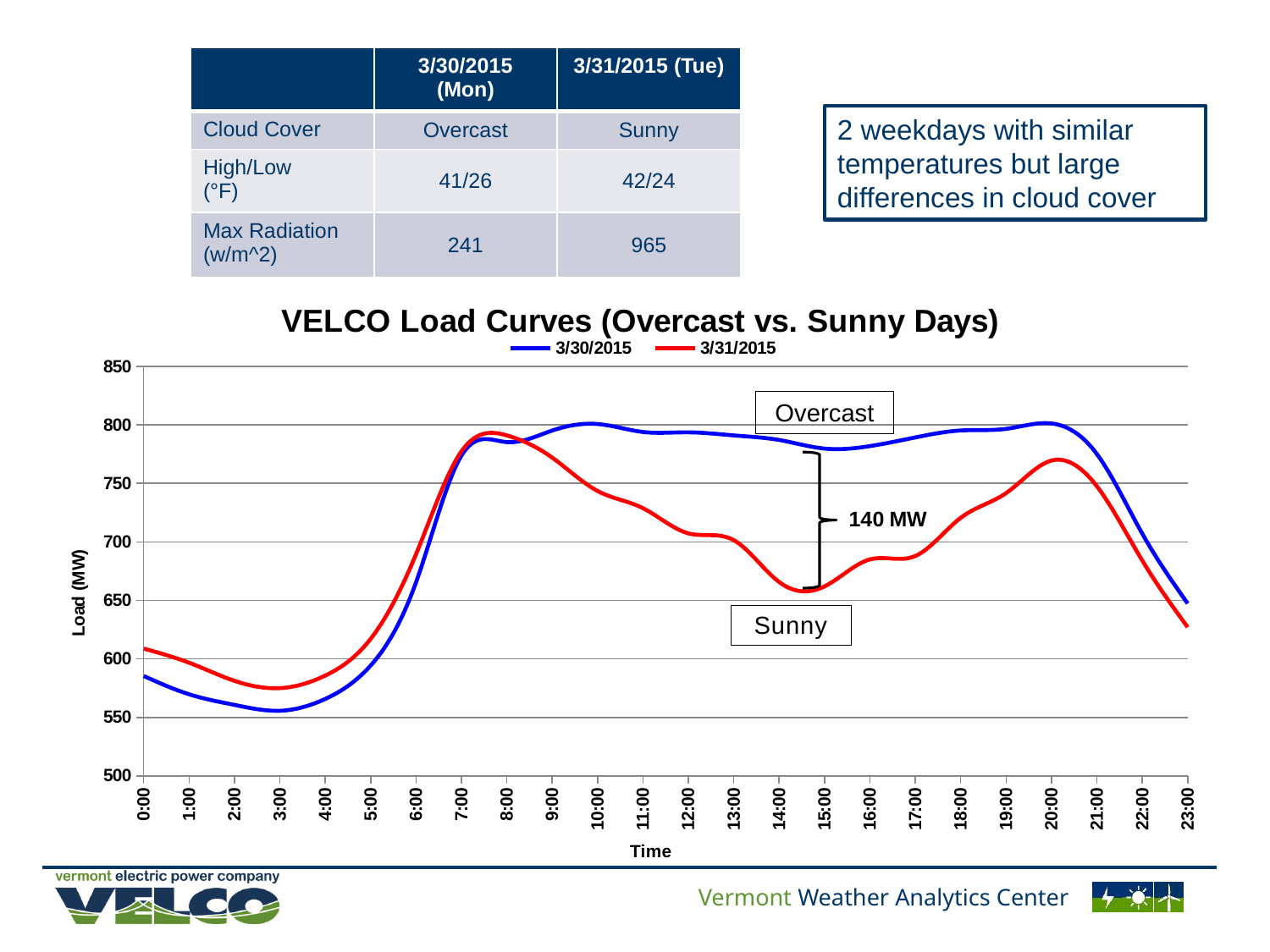
What is the title of the chart? VELCO Load Curves (Overcast vs. Sunny Days) What load difference between the two curves is annotated on the chart around 14:00–15:00? 140 MW At 12:00, which series has the higher load, 3/30/2015 or 3/31/2015? 3/30/2015 How many series does the chart legend list? 2 At 2:00, which series has the higher load, 3/30/2015 or 3/31/2015? 3/31/2015 Is the value for 3/30/2015 at 10:00 greater or less than 750? greater What are the two series named in the chart legend? 3/30/2015 and 3/31/2015 How many time points are labelled along the x axis of the chart? 24 Does the 3/31/2015 load rise or fall between 20:00 and 23:00? fall What type of chart is shown on the slide? line chart Is the value for 3/30/2015 at 3:00 greater or less than 600? less Is the value for 3/31/2015 at 14:00 greater or less than 700? less